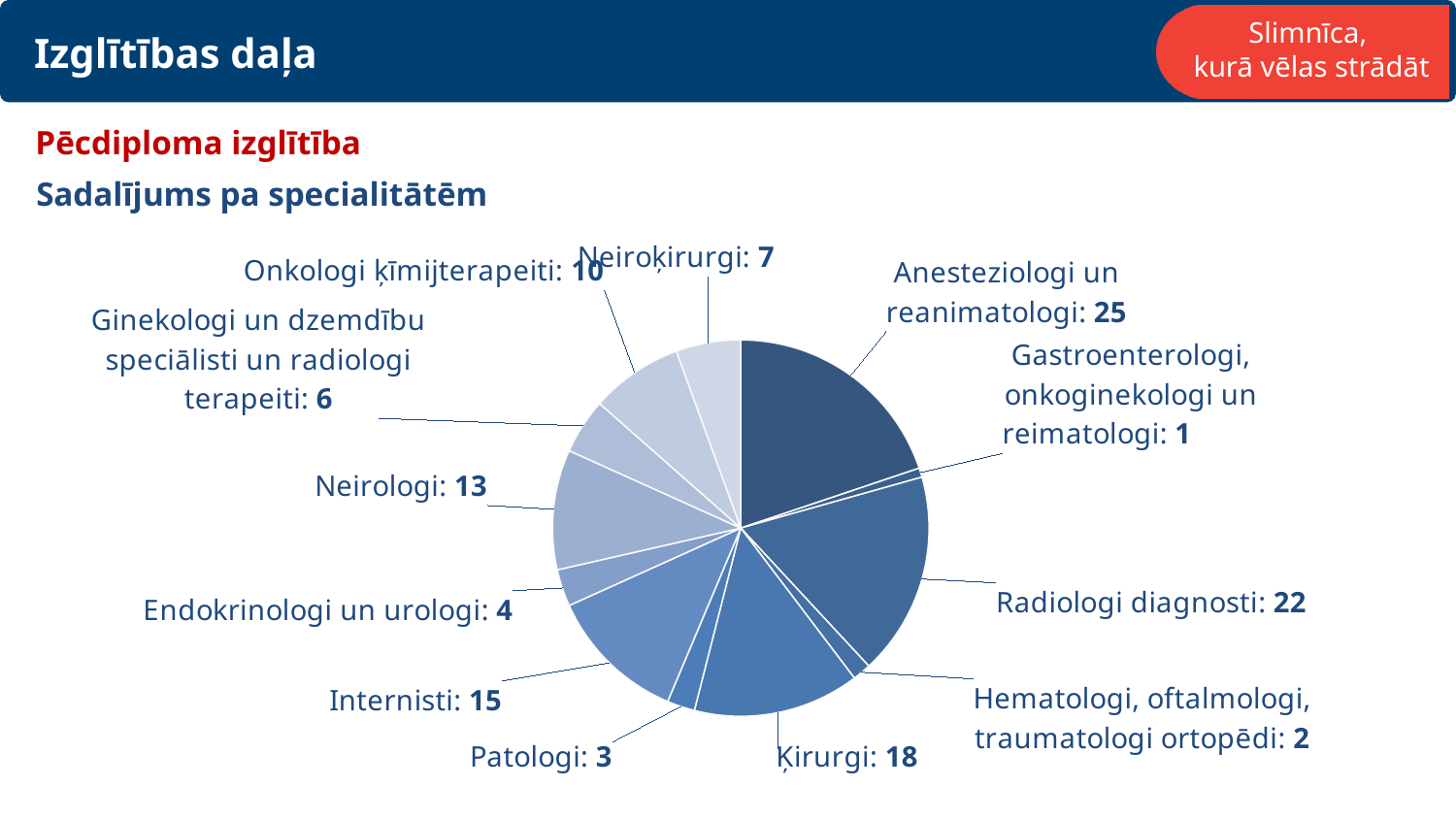
What is the difference between the values for Anesteziologi un reanimatologi and Radiologi diagnosti? 3 Which speciality has the largest slice of the pie? Anesteziologi un reanimatologi What is the value for Anesteziologi un reanimatologi? 25 How many specialities (slices) does the pie chart show? 12 What kind of chart is shown on the slide? Pie chart What is the total of all the values shown in the pie chart? 126 Which speciality has the smallest slice of the pie? Gastroenterologi, onkoginekologi un reimatologi What is the heading shown directly above the pie chart? Sadalījums pa specialitātēm What is the value for Ķirurgi? 18 What is the value for Neirologi? 13 Which is larger, the value for Internisti or the value for Neirologi? Internisti What is the value for Radiologi diagnosti? 22